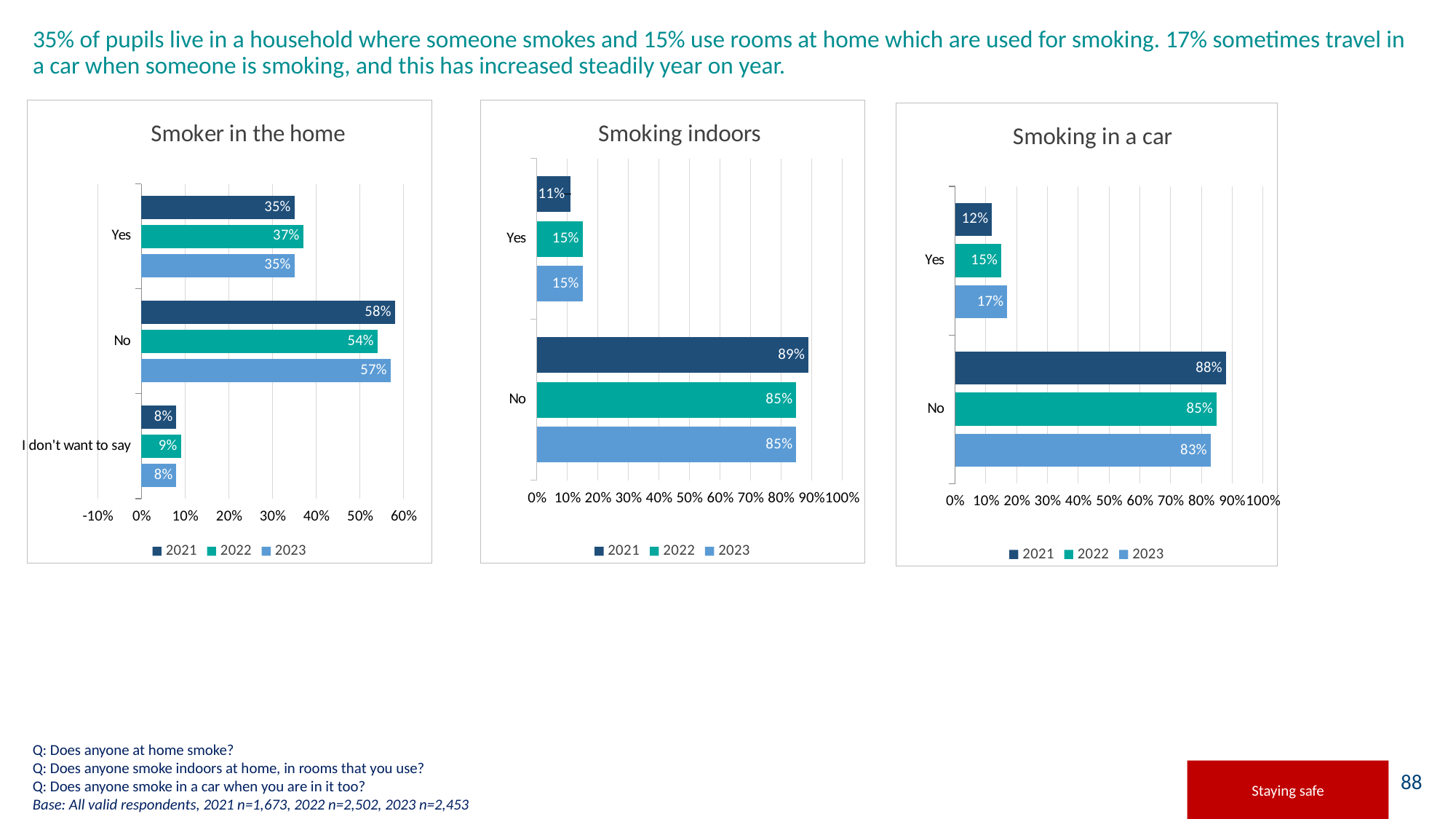
How many categories are shown in the 'Smoker in the home' chart? 3 In the 'Smoker in the home' chart, which category has the lowest values across all years? I don't want to say In the 'Smoking in a car' chart, do the 'Yes' values rise or fall from 2021 to 2023? rise In the 'Smoker in the home' chart, what is the value for 'No' in 2021? 58% In the 'Smoking indoors' chart, which year has the highest value for 'No'? 2021 In the 'Smoking indoors' chart, what is the value for 'Yes' in 2021? 11% In the 'Smoking in a car' chart, what is the difference between the 'No' values for 2021 and 2023? 5% What kind of chart is the 'Smoking in a car' chart? bar chart How many series does the legend list in the 'Smoking indoors' chart? 3 In the 'Smoking in a car' chart, what is the value for 'Yes' in 2023? 17% In the 'Smoker in the home' chart, is the 2022 value for 'No' larger or smaller than the 2023 value for 'No'? smaller In the 'Smoker in the home' chart, what is the value for 'Yes' in 2023? 35%